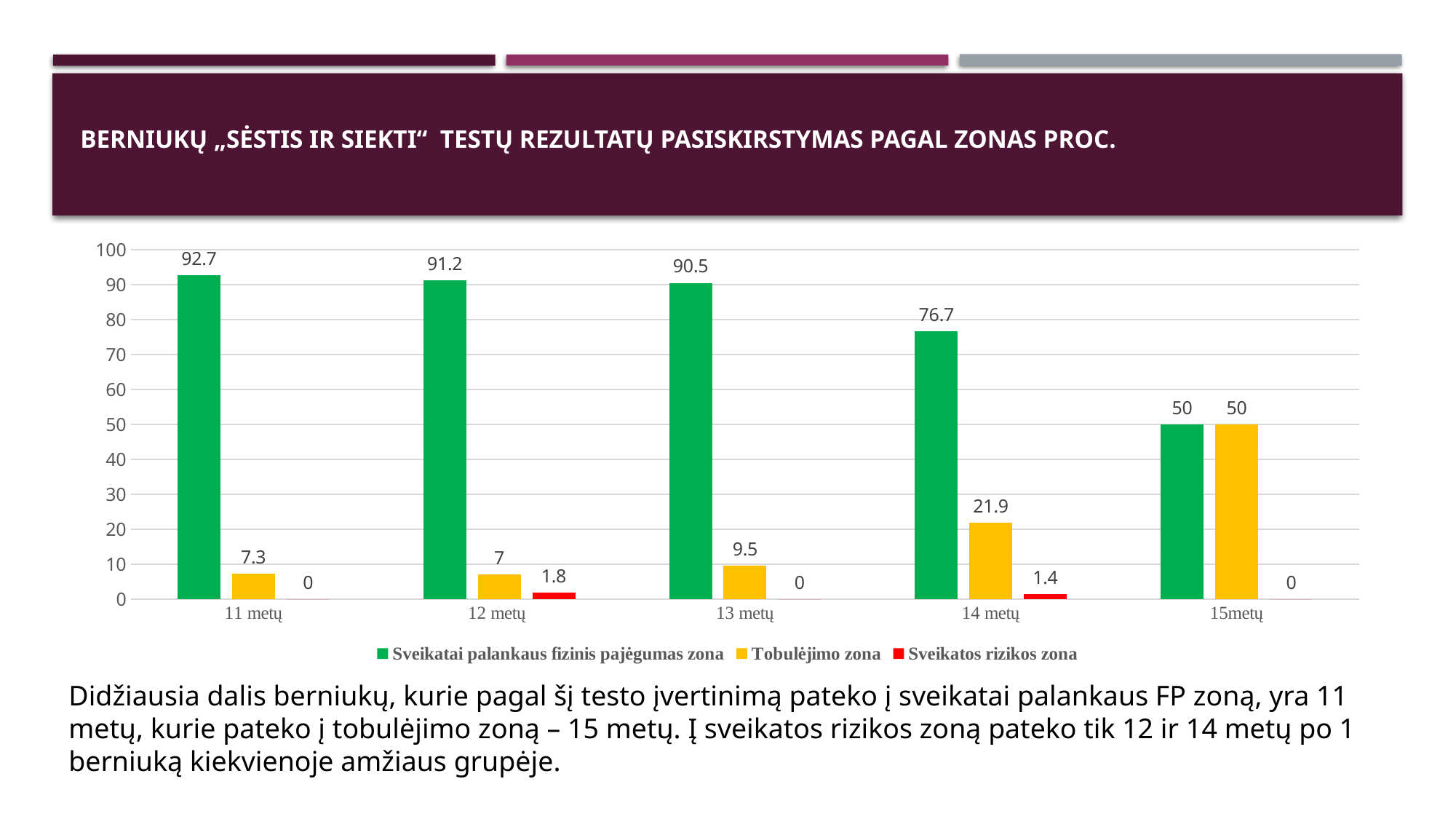
How many age groups are shown on the x axis? 5 What is the difference between the "Sveikatai palankaus fizinis pajėgumas zona" values for 11 metų and 14 metų? 16 Do the "Sveikatai palankaus fizinis pajėgumas zona" values rise or fall from 11 metų to 15metų? fall What kind of chart is shown on the slide? bar chart What is the value of "Sveikatos rizikos zona" for 12 metų? 1.8 Which age group has the highest value for "Sveikatai palankaus fizinis pajėgumas zona"? 11 metų What is the value of "Sveikatai palankaus fizinis pajėgumas zona" for 11 metų? 92.7 What is the value of "Tobulėjimo zona" for 14 metų? 21.9 Which is larger: the "Tobulėjimo zona" value for 13 metų or for 14 metų? 14 metų Is the "Sveikatai palankaus fizinis pajėgumas zona" value for 14 metų greater or less than 80? less How many series does the legend list? 3 Which age group has the lowest value for "Sveikatai palankaus fizinis pajėgumas zona"? 15metų